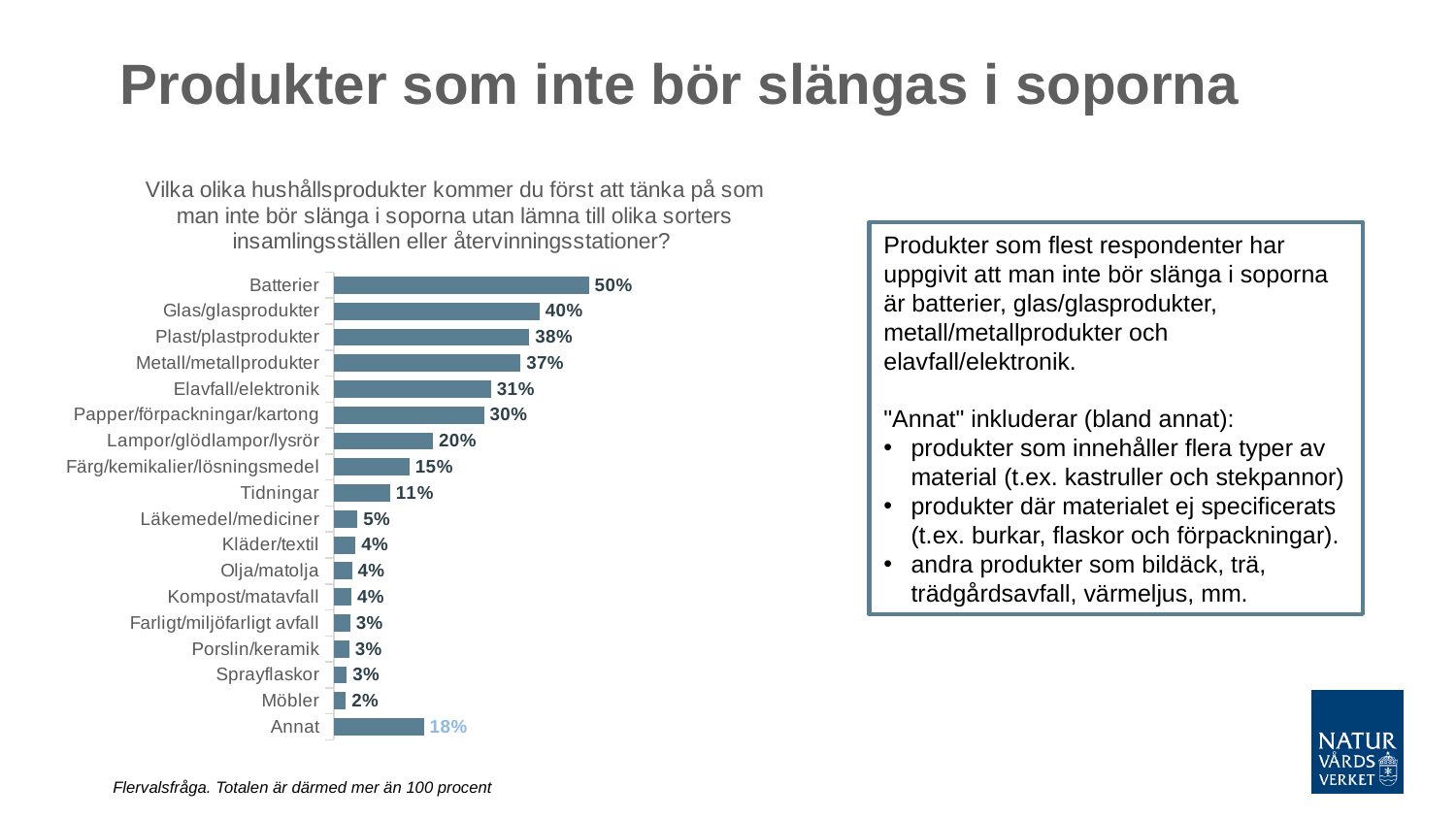
What is the value for Annat? 18% Which category has the highest value? Batterier Which category has the lowest value? Möbler What kind of chart is shown on the slide? Bar chart What is the value for Batterier? 50% Which is larger, the value for Plast/plastprodukter or the value for Papper/förpackningar/kartong? Plast/plastprodukter What is the difference between the values for Batterier and Glas/glasprodukter? 10% What is the difference between the values for Lampor/glödlampor/lysrör and Färg/kemikalier/lösningsmedel? 5% Which category's data label is shown in a lighter blue colour than the others? Annat What is the value for Elavfall/elektronik? 31% How many categories are shown in the chart? 18 What is the value for Tidningar? 11%